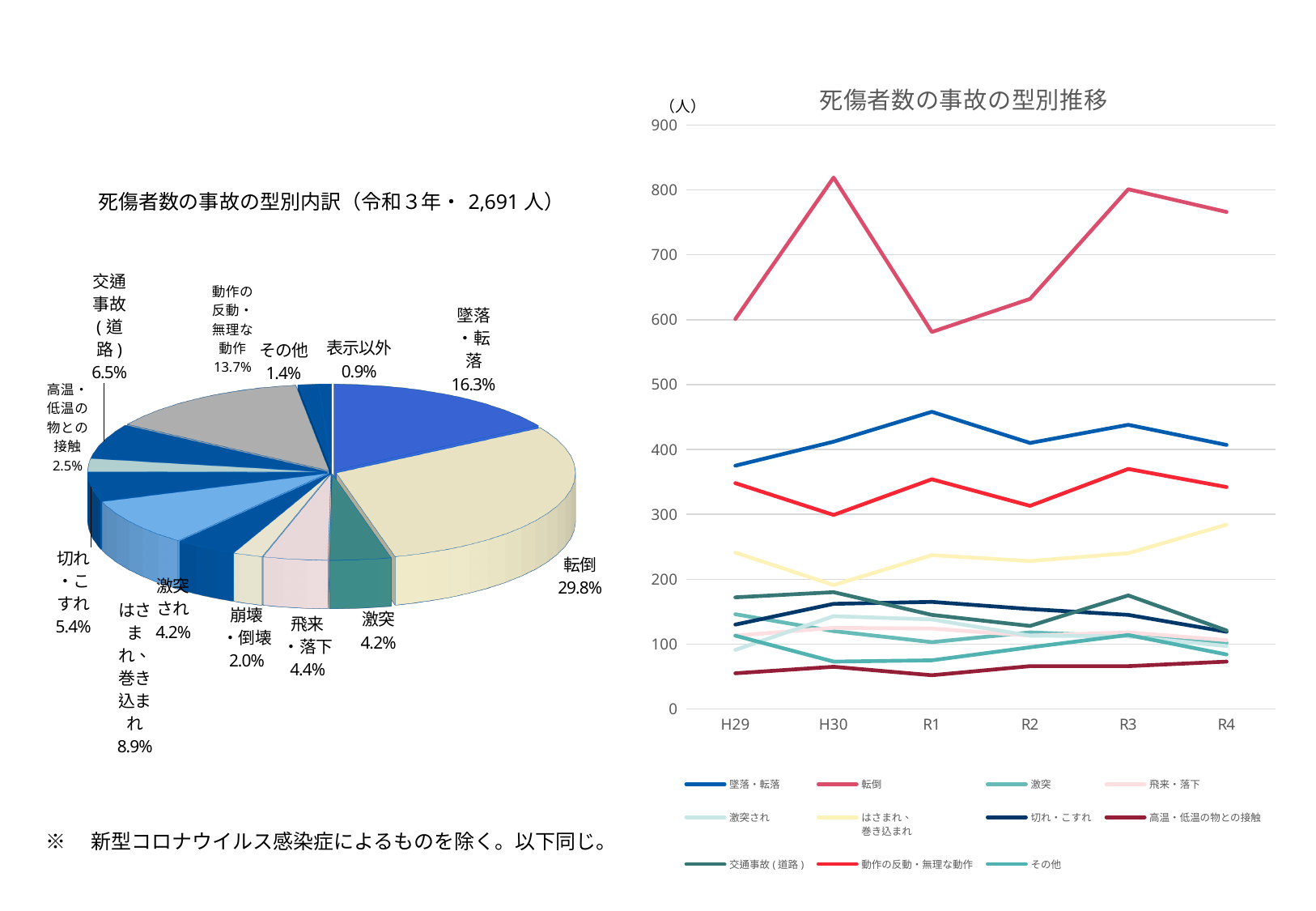
In the pie chart on the left, what share does 動作の反動・無理な動作 have? 13.7% In the line chart 死傷者数の事故の型別推移, is the value for 転倒 at H30 greater or less than 800? greater In the pie chart on the left, which category has the largest share? 転倒 In the pie chart on the left, which is larger: the share of はさまれ、巻き込まれ or the share of 交通事故(道路)? はさまれ、巻き込まれ In the pie chart on the left, which category has the smallest share? 表示以外 In the line chart 死傷者数の事故の型別推移, in which year does the 転倒 series reach its highest value? H30 In the pie chart on the left, what share does 墜落・転落 have? 16.3% How many series does the legend of the line chart 死傷者数の事故の型別推移 list? 11 What kind of chart is the chart on the left? Pie chart In the pie chart on the left, what share does 転倒 have? 29.8% In the pie chart on the left, what is the difference between the shares of 転倒 and 墜落・転落? 13.5% How many categories are shown in the pie chart on the left? 13